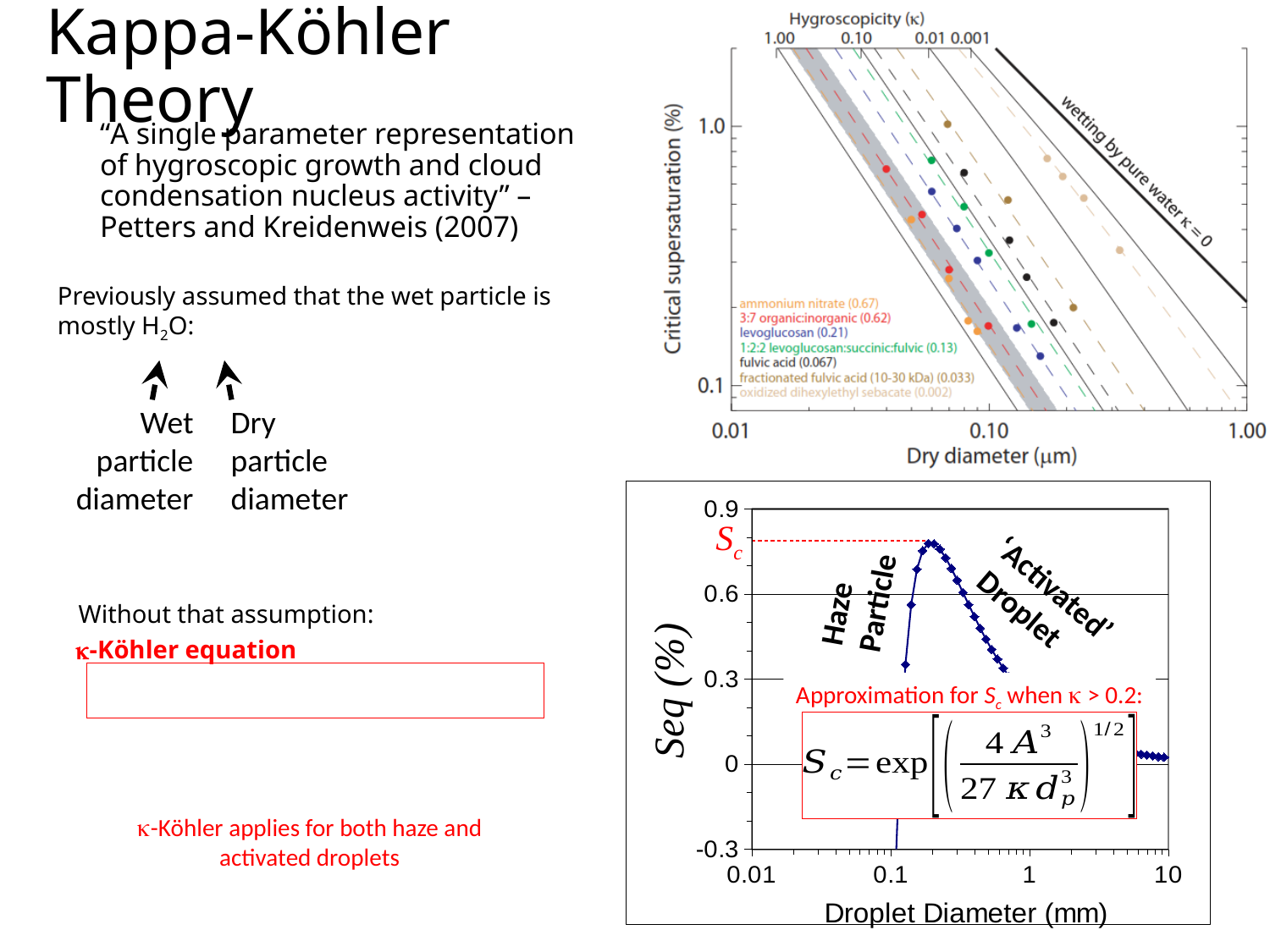
In the top-right chart, what hygroscopicity (κ) value is given for levoglucosan in the legend? 0.21 In the top-right chart, what is the label of the y axis? Critical supersaturation (%) In the top-right chart, how many substances are listed in the legend? 7 In the bottom-right chart, is the peak value of Seq (%) (marked Sc) greater or less than 0.6? greater In the top-right chart, what hygroscopicity (κ) value is given for fulvic acid in the legend? 0.067 In the top-right chart, what is the label of the x axis? Dry diameter (μm) In the top-right chart, which legend substance has the highest hygroscopicity (κ) value? ammonium nitrate (0.67) In the top-right chart, which legend substance has the lowest hygroscopicity (κ) value? oxidized dihexylethyl sebacate (0.002) What kind of chart is the bottom-right chart of Seq (%) versus Droplet Diameter? line chart In the bottom-right chart, what is the label of the x axis? Droplet Diameter (mm) In the top-right chart, does critical supersaturation rise or fall as dry diameter increases? fall In the top-right chart, which has the larger κ value: ammonium nitrate or 3:7 organic:inorganic? ammonium nitrate